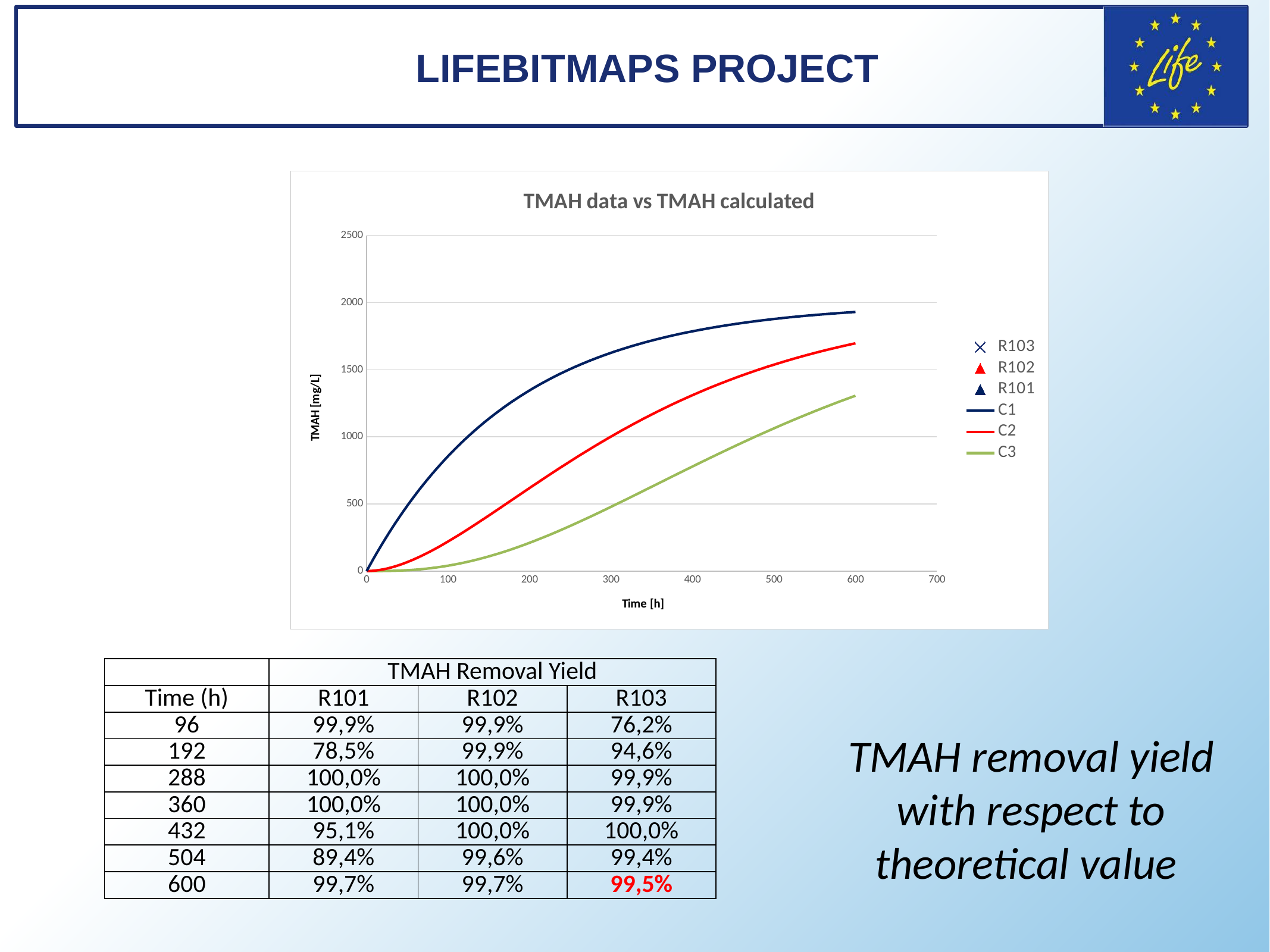
How many entries does the legend of the chart list? 6 Does the C1 curve rise or fall as time increases along the x axis? rise At 400 h, which curve has the larger value, C2 or C3? C2 Is the value of C1 at 100 h greater or less than 500? greater Which curve reaches the highest value at 600 h in the chart? C1 Is the value of C3 at 600 h greater or less than 1500? less What is the label of the y axis of the chart? TMAH [mg/L] Is the value of C1 at 600 h greater or less than 1500? greater What kind of chart is "TMAH data vs TMAH calculated"? line chart Which curve has the lowest value at 600 h in the chart? C3 What is the title of the chart on the slide? TMAH data vs TMAH calculated